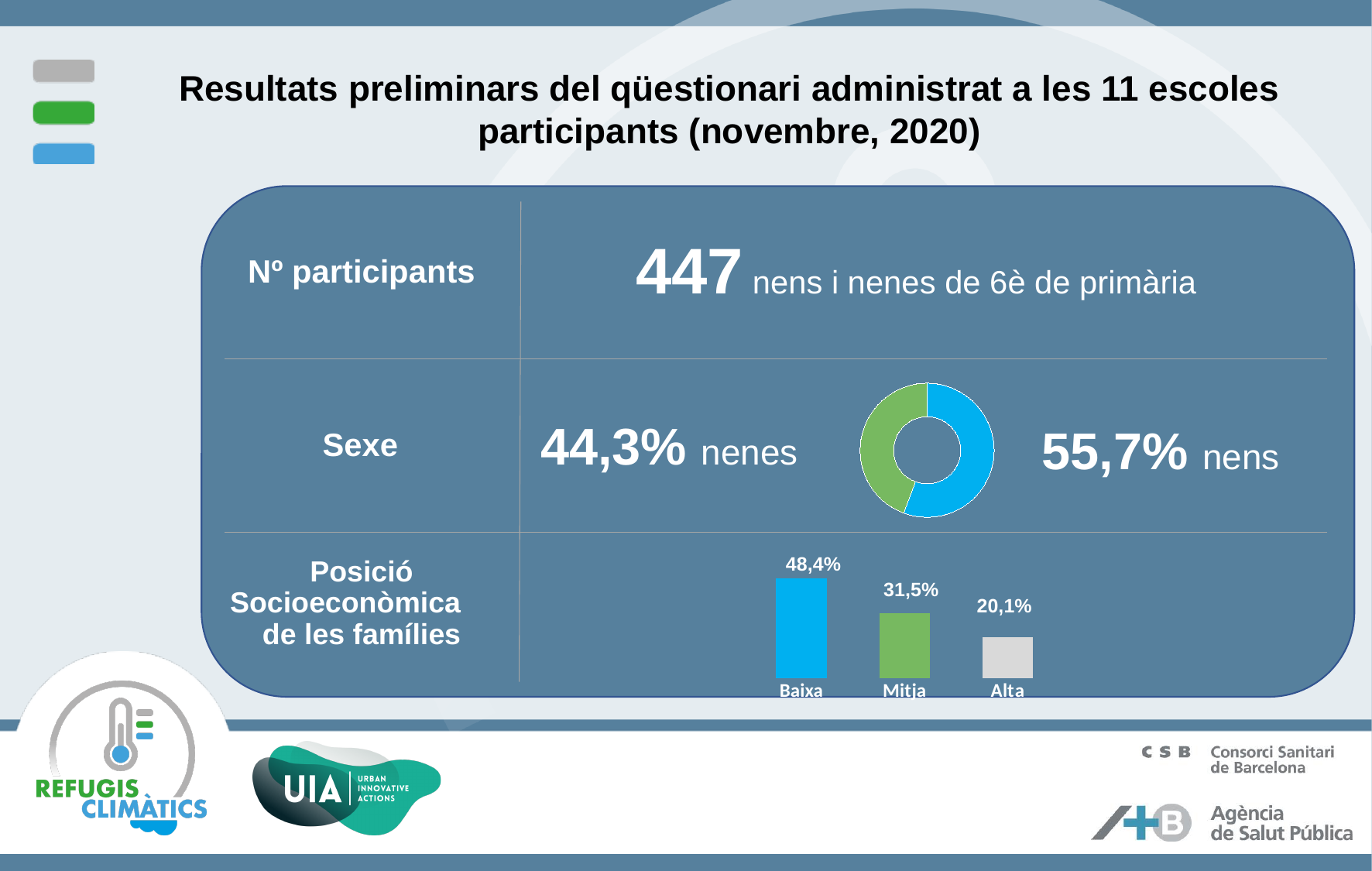
In the bar chart for Posició Socioeconòmica de les famílies, which category has the lowest value? Alta In the bar chart for Posició Socioeconòmica de les famílies, do the values rise or fall from Baixa to Alta? Fall In the Sexe donut chart, what share of participants are nenes? 44,3% In the bar chart for Posició Socioeconòmica de les famílies, what is the value for Alta? 20,1% What kind of chart is used for Posició Socioeconòmica de les famílies? Bar chart In the bar chart for Posició Socioeconòmica de les famílies, what is the difference between the values for Baixa and Alta? 28,3% In the Sexe donut chart, what share of participants are nens? 55,7% In the bar chart for Posició Socioeconòmica de les famílies, what is the value for Mitja? 31,5% In the bar chart for Posició Socioeconòmica de les famílies, which is larger, Mitja or Alta? Mitja In the bar chart for Posició Socioeconòmica de les famílies, which category has the highest value? Baixa How many categories are shown in the bar chart for Posició Socioeconòmica de les famílies? 3 In the bar chart for Posició Socioeconòmica de les famílies, what is the value for Baixa? 48,4%